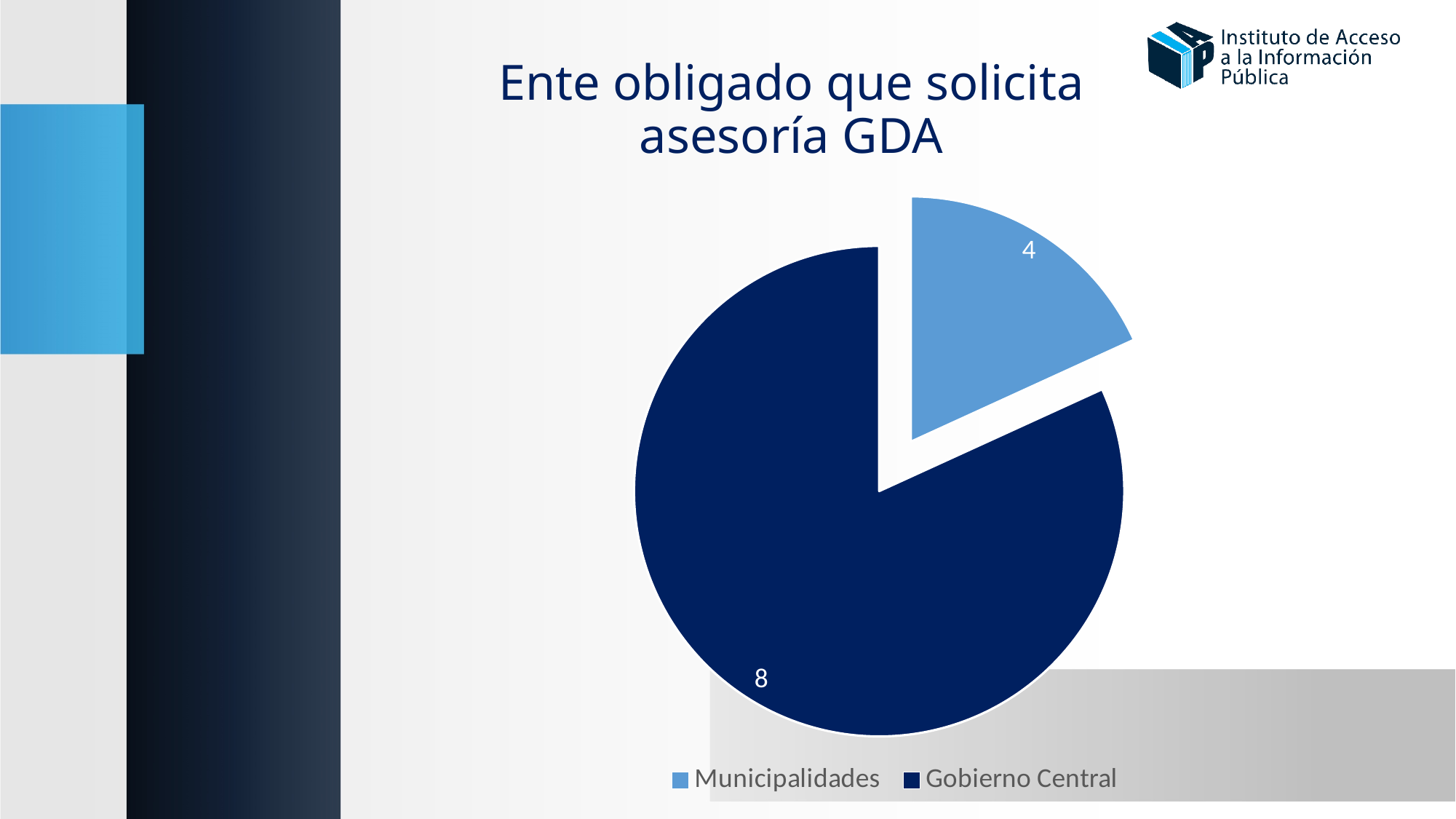
What type of chart is shown on the slide? pie chart How many slices does the pie chart have? 2 How many entries does the legend list? 2 Which category has the smallest slice? Municipalidades Which legend entry is shown in the lighter blue colour? Municipalidades What is the difference between the values for Gobierno Central and Municipalidades? 4 What is the value for Gobierno Central? 8 What is the total of all slices in the pie chart? 12 What is the value for Municipalidades? 4 Which is larger, the value for Municipalidades or the value for Gobierno Central? Gobierno Central What is the title of the chart? Ente obligado que solicita asesoría GDA Which category has the largest slice? Gobierno Central